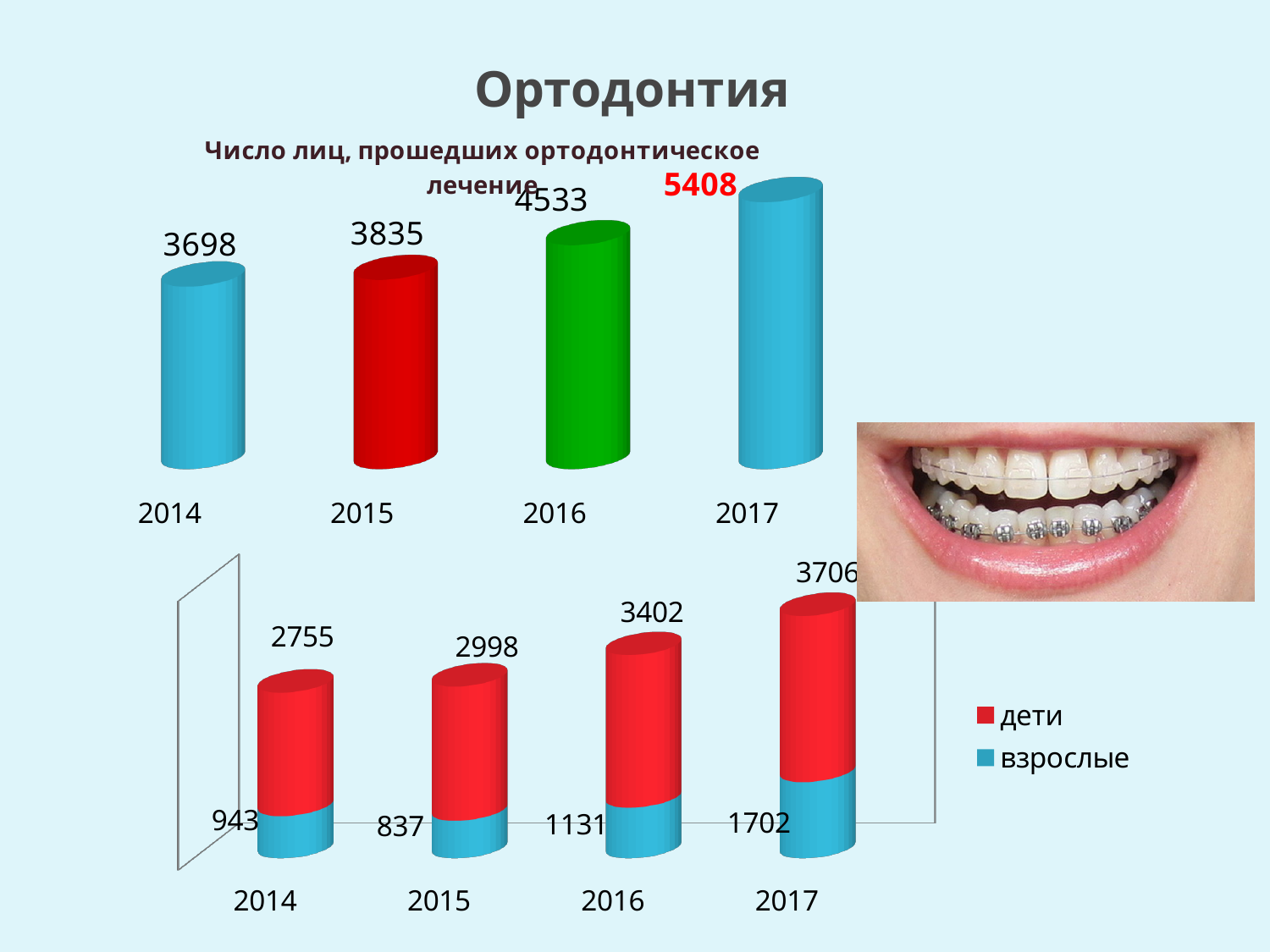
In the bottom stacked chart, what is the value for взрослые in 2015? 837 In the bottom stacked chart, what is the value for дети in 2016? 3402 In the bottom stacked chart, which year has the lowest value for взрослые? 2015 In the top chart 'Число лиц, прошедших ортодонтическое лечение', what is the value for 2017? 5408 In the bottom stacked chart, what is the total of the 2017 bar (дети plus взрослые)? 5408 In the top chart 'Число лиц, прошедших ортодонтическое лечение', which year has the lowest value? 2014 In the bottom stacked chart, how many series does the legend list? 2 In the top chart 'Число лиц, прошедших ортодонтическое лечение', what is the difference between the 2017 and 2016 values? 875 In the top chart 'Число лиц, прошедших ортодонтическое лечение', how many years are shown? 4 In the bottom stacked chart, which series is shown in red? дети In the top chart 'Число лиц, прошедших ортодонтическое лечение', do the values rise or fall from 2014 to 2017? rise In the top chart 'Число лиц, прошедших ортодонтическое лечение', what is the value for 2014? 3698